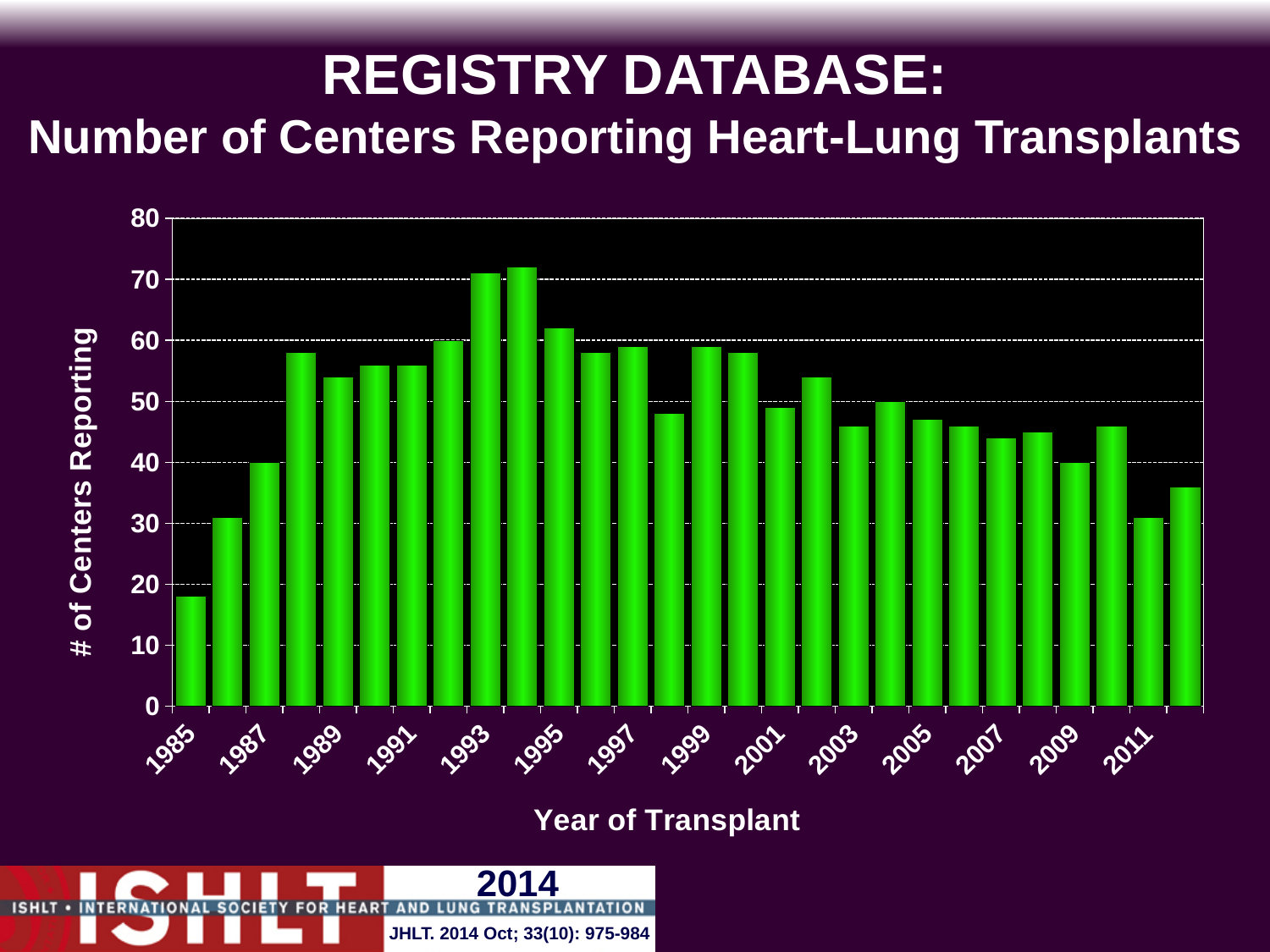
Which year has more centers reporting, 1985 or 1987? 1987 What is the title of the vertical axis? # of Centers Reporting How many bars are plotted in the chart? 28 Is the value for 1995 greater or less than 60? greater Do the values rise or fall from 1985 to 1988? rise Which year has the lowest number of centers reporting? 1985 Is the value for 1998 greater or less than 50? less What kind of chart is shown on the slide? bar chart Which year has more centers reporting, 1993 or 1999? 1993 Is the value for 1985 greater or less than 20? less